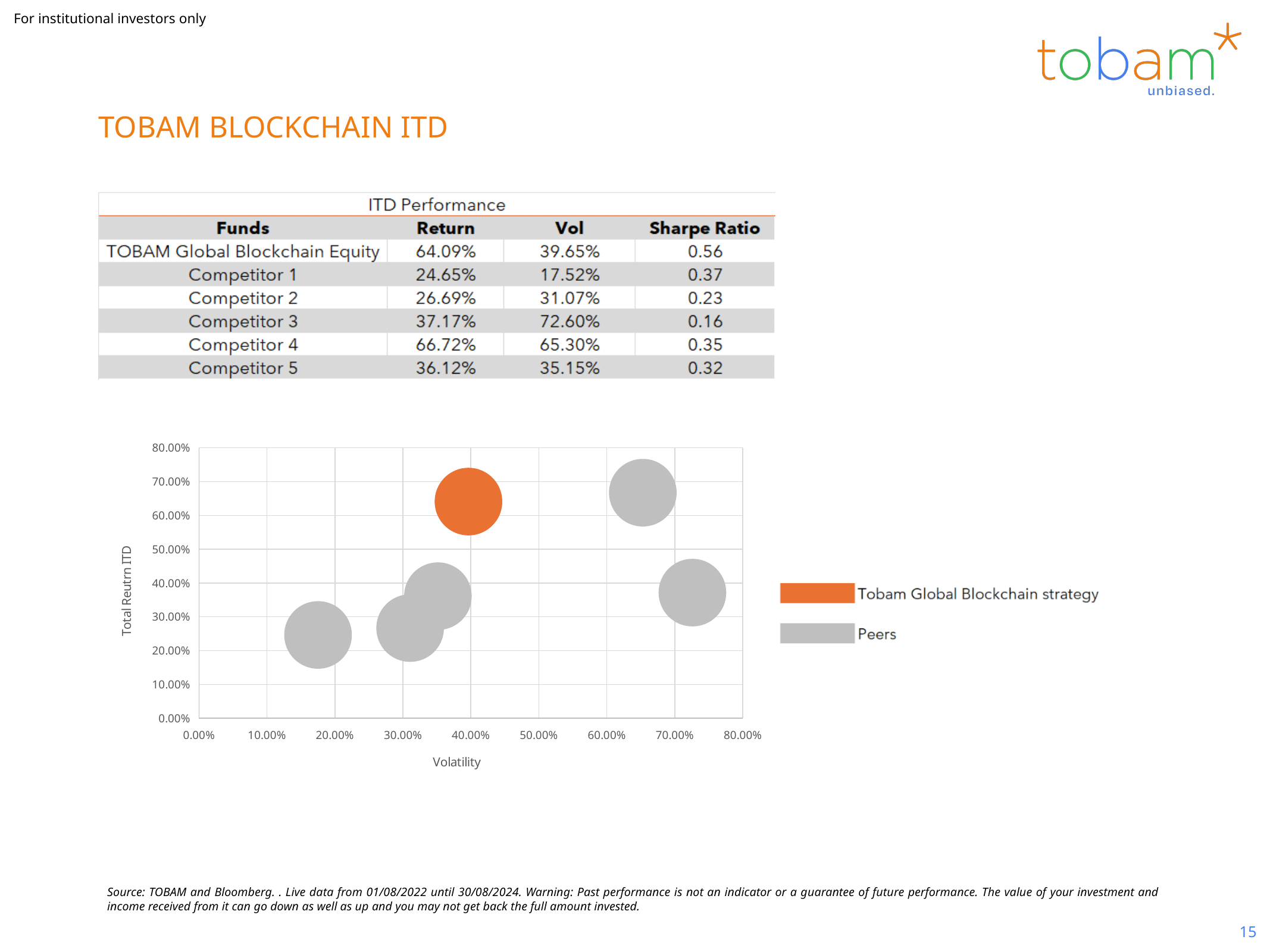
According to the ITD Performance table, which has the higher Vol: Competitor 3 or Competitor 4? Competitor 3 According to the ITD Performance table, which fund has the lowest Sharpe Ratio? Competitor 3 According to the ITD Performance table, what is the Return of TOBAM Global Blockchain Equity? 64.09% How many grey (Peers) bubbles are plotted on the chart? 5 According to the ITD Performance table, which fund has the highest Sharpe Ratio? TOBAM Global Blockchain Equity What is the label of the chart's x axis? Volatility How many series does the chart legend list? 2 Is the Volatility of the orange Tobam Global Blockchain strategy bubble greater or less than 50.00%? less How many bubbles are plotted on the chart? 6 Which legend entry is shown in orange? Tobam Global Blockchain strategy Is the Total Return ITD of the orange Tobam Global Blockchain strategy bubble greater or less than 50.00%? greater What kind of chart is shown on the slide? bubble chart